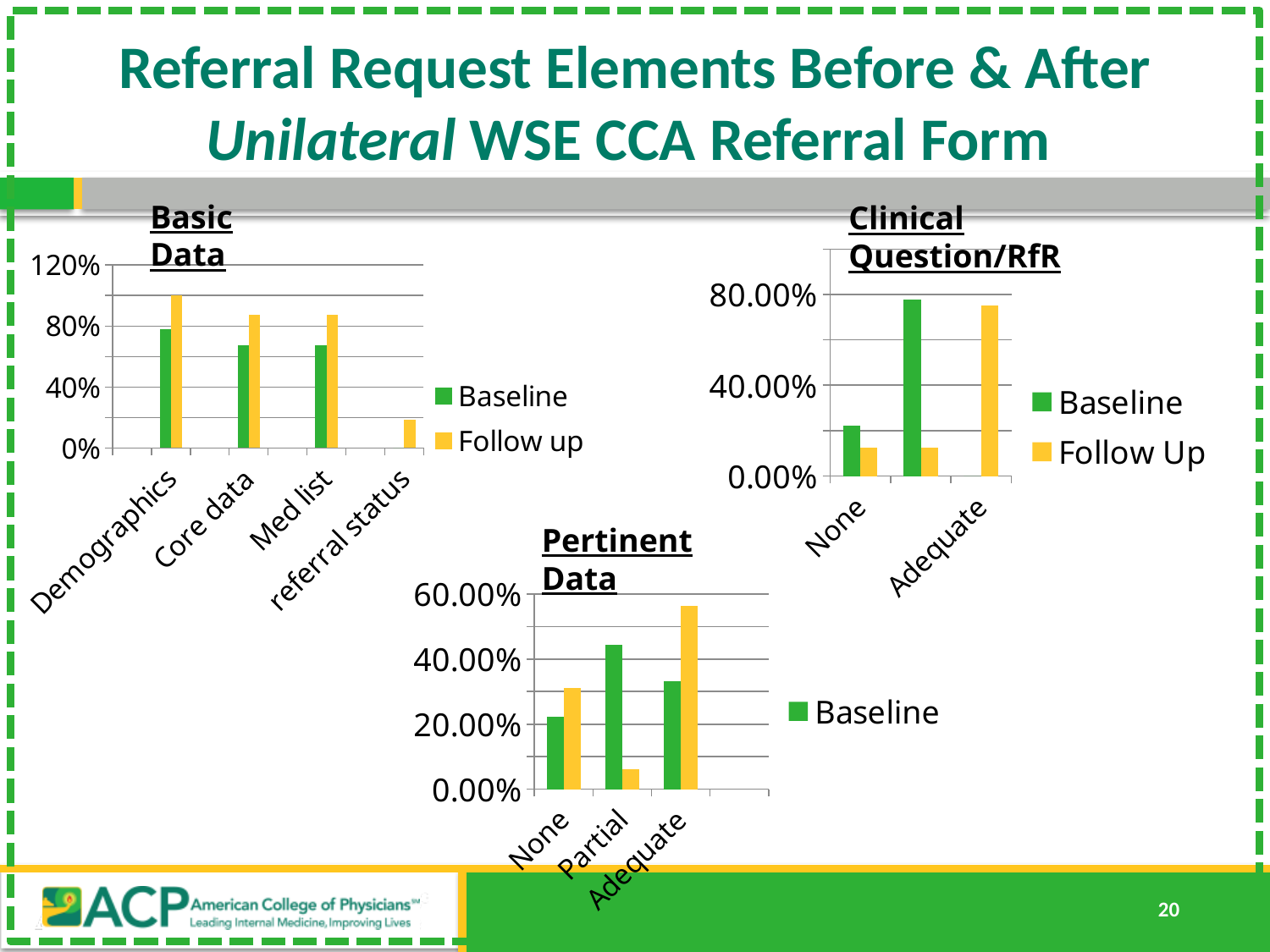
How many series does the legend of the "Basic Data" chart list? 2 How many categories are shown on the x axis of the "Pertinent Data" chart? 3 What kind of chart is the "Basic Data" chart? bar chart How many categories are shown on the x axis of the "Basic Data" chart? 4 In the "Basic Data" chart, which category has the lowest Follow up value? referral status How many series does the legend of the "Clinical Question/RfR" chart list? 2 In the "Clinical Question/RfR" chart, is the Baseline value for None greater or less than 40.00%? less In the "Basic Data" chart, is the Follow up value for Demographics greater or less than 80%? greater In the "Basic Data" chart, which category has the highest Follow up value? Demographics In the "Basic Data" chart, is the Baseline value for Core data greater or less than 80%? less In the "Pertinent Data" chart, which category has the highest Baseline value? Partial In the "Basic Data" chart, which is larger for Demographics: Baseline or Follow up? Follow up